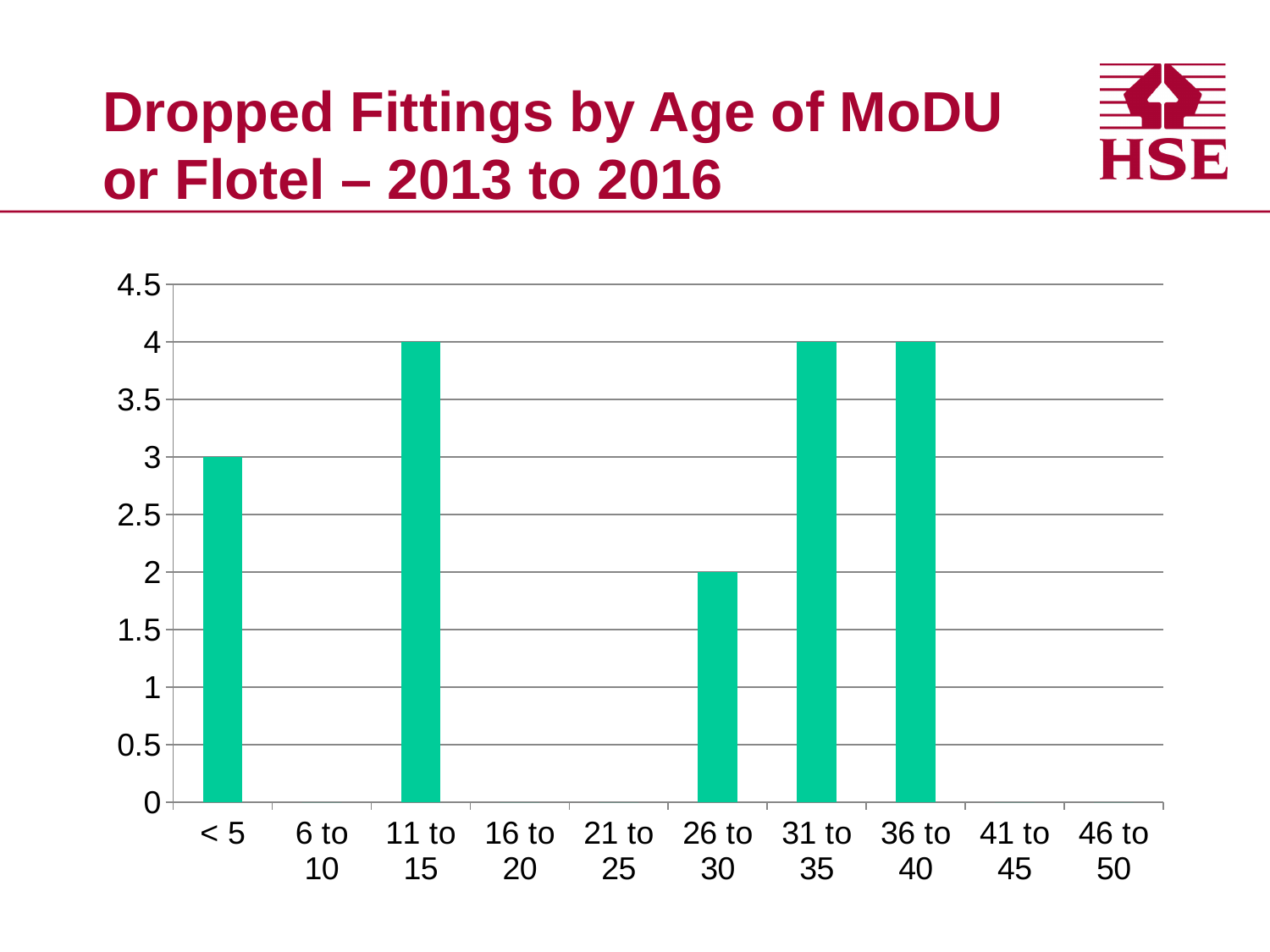
What is the highest value shown by any bar on the chart? 4 What is the value for the 36 to 40 age category? 4 What is the value for the < 5 age category? 3 What is the difference between the values for < 5 and 26 to 30? 1 How many age categories are shown on the x axis? 10 Which has the larger value, < 5 or 11 to 15? 11 to 15 Which has the larger value, 26 to 30 or 31 to 35? 31 to 35 What is the value for the 11 to 15 age category? 4 What kind of chart is shown on the slide? bar chart What is the title of the slide? Dropped Fittings by Age of MoDU or Flotel – 2013 to 2016 Is the value for 26 to 30 greater or less than 3? less What is the value for the 26 to 30 age category? 2